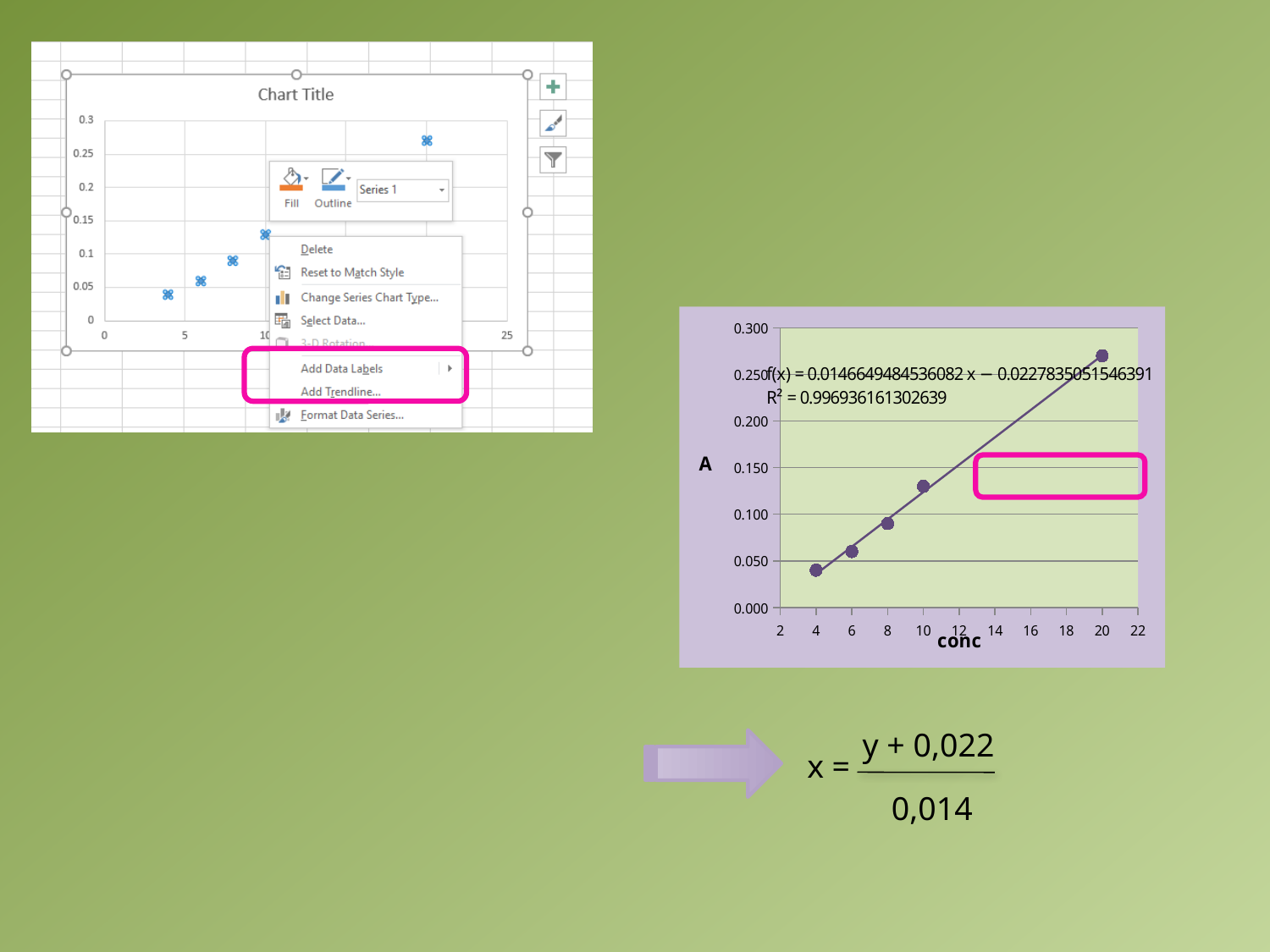
In the chart on the right (A vs conc), at which conc value is A highest? 20 In the Excel chart screenshot on the top left of the slide, how many data points are plotted? 5 In the chart on the right (A vs conc), is the value of A at conc 20 greater or less than 0.250? greater In the chart on the right (A vs conc), is the value of A at conc 4 greater or less than 0.050? less In the chart on the right (A vs conc), what R² value is shown for the trendline? R² = 0.996936161302639 In the chart on the right (A vs conc), how many data points are plotted? 5 In the chart on the right (A vs conc), is the value of A at conc 10 greater or less than 0.150? less What kind of chart is the chart on the right side of the slide (A vs conc)? scatter chart In the chart on the right (A vs conc), which has the larger value of A: conc 6 or conc 10? conc 10 In the chart on the right (A vs conc), do the values of A rise or fall as conc increases? rise In the chart on the right (A vs conc), at which conc value is A lowest? 4 What is the label of the x axis on the chart on the right side of the slide? conc